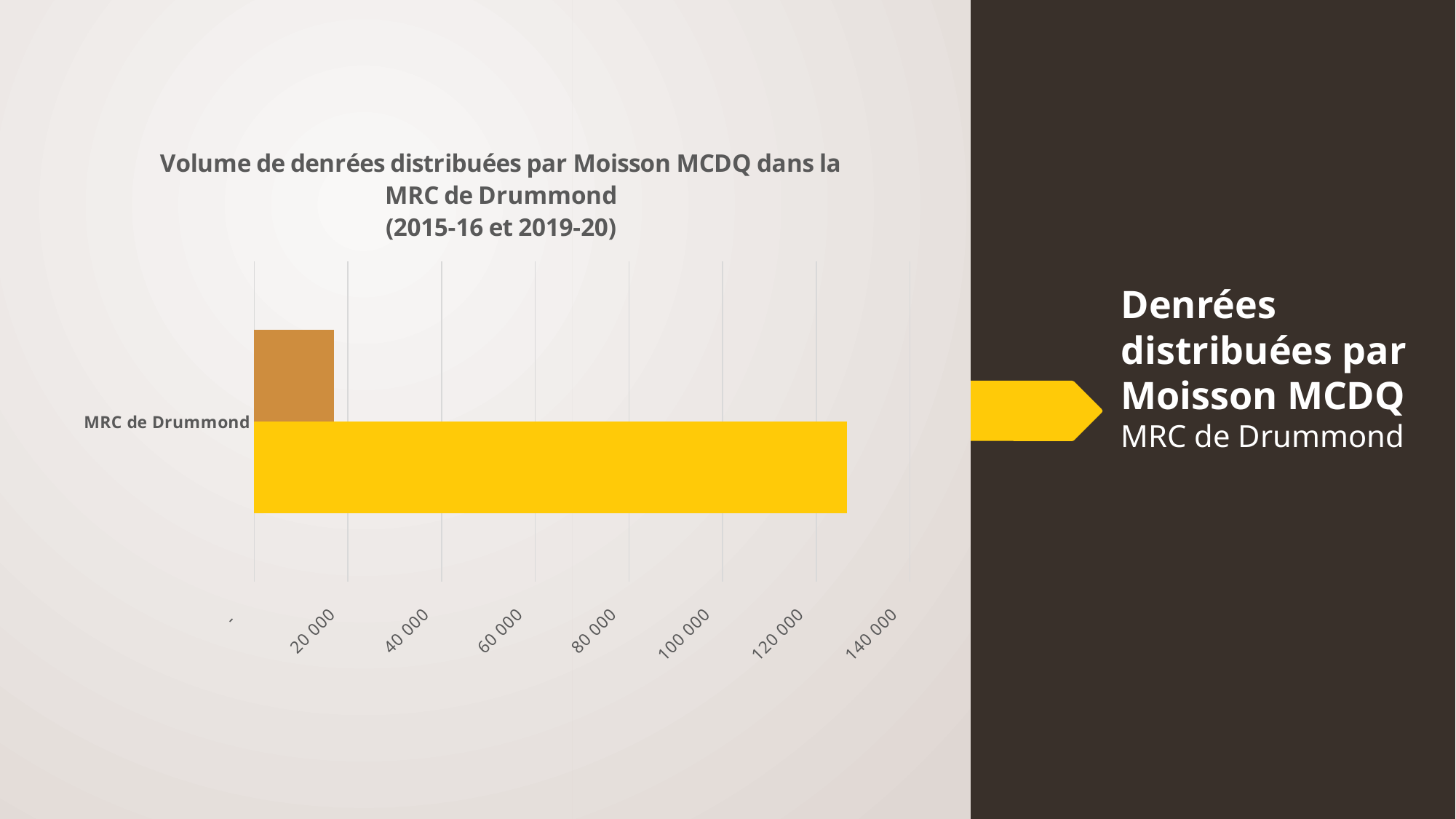
Is the value of the brown bar for MRC de Drummond greater or less than 20 000? less Is the value of the yellow bar for MRC de Drummond greater or less than 140 000? less Which bar is the smallest in the chart? the brown bar Which bar is larger for MRC de Drummond, the yellow bar or the brown bar? the yellow bar What is the title of the chart? Volume de denrées distribuées par Moisson MCDQ dans la MRC de Drummond (2015-16 et 2019-20) How many categories are shown on the vertical axis of the chart? 1 Is the value of the yellow bar for MRC de Drummond greater or less than 120 000? greater How many bars are plotted in the chart? 2 What kind of chart is shown on the slide? bar chart What is the highest tick label shown on the horizontal axis of the chart? 140 000